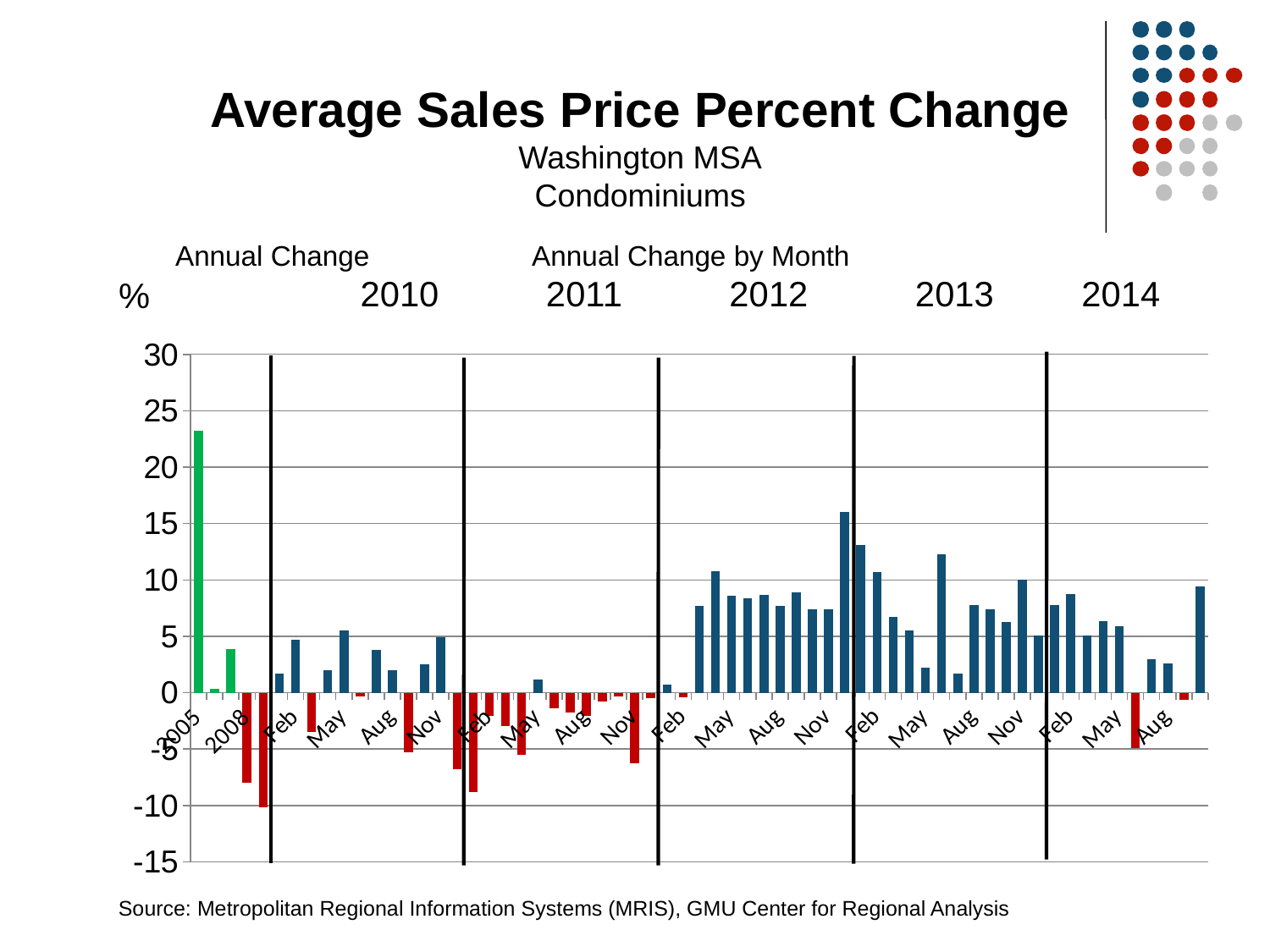
What is the title of the chart? Average Sales Price Percent Change Which is larger, the annual change for 2005 or for 2007? 2005 Is the annual change value for 2009 greater or less than -5? less Do the annual change values rise or fall from 2005 to 2009? fall Is the annual change value for 2005 greater or less than 20? greater Is the annual change value for 2007 greater or less than 5? less How many years are shown in the Annual Change section (2005 through 2009)? 5 What property type does the chart cover, according to the subtitle? Condominiums Which year has the highest bar in the Annual Change section? 2005 What kind of chart is shown on the slide? bar chart Which year has the lowest bar in the Annual Change section? 2009